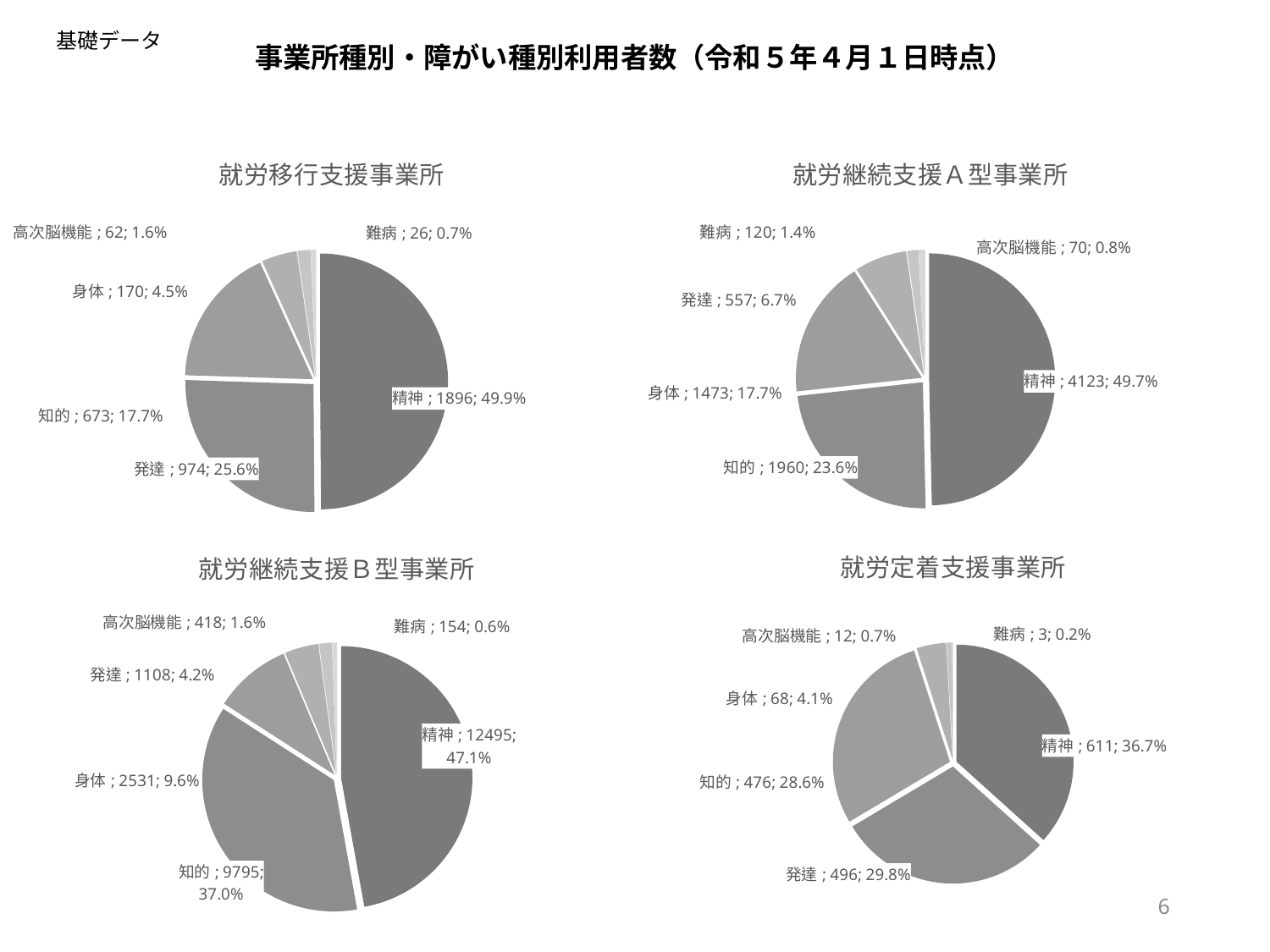
In the 就労定着支援事業所 pie chart, which is larger, 発達 or 知的? 発達 In the 就労移行支援事業所 pie chart, what is the difference between the values for 発達 and 知的? 301 In the 就労定着支援事業所 pie chart, what share of the pie does 精神 represent? 36.7% In the 就労継続支援Ｂ型事業所 pie chart, what is the difference between the values for 精神 and 知的? 2700 In the 就労継続支援Ｂ型事業所 pie chart, which category is the largest? 精神 In the 就労移行支援事業所 pie chart, what is the value for 精神? 1896 How many categories are shown in the 就労移行支援事業所 pie chart? 6 In the 就労継続支援Ａ型事業所 pie chart, what is the value for 身体? 1473 How many pie charts are shown on the slide? 4 In the 就労定着支援事業所 pie chart, which category is the smallest? 難病 What type of chart is used for 就労継続支援Ａ型事業所? Pie chart In the 就労継続支援Ａ型事業所 pie chart, what share of the pie does 知的 represent? 23.6%